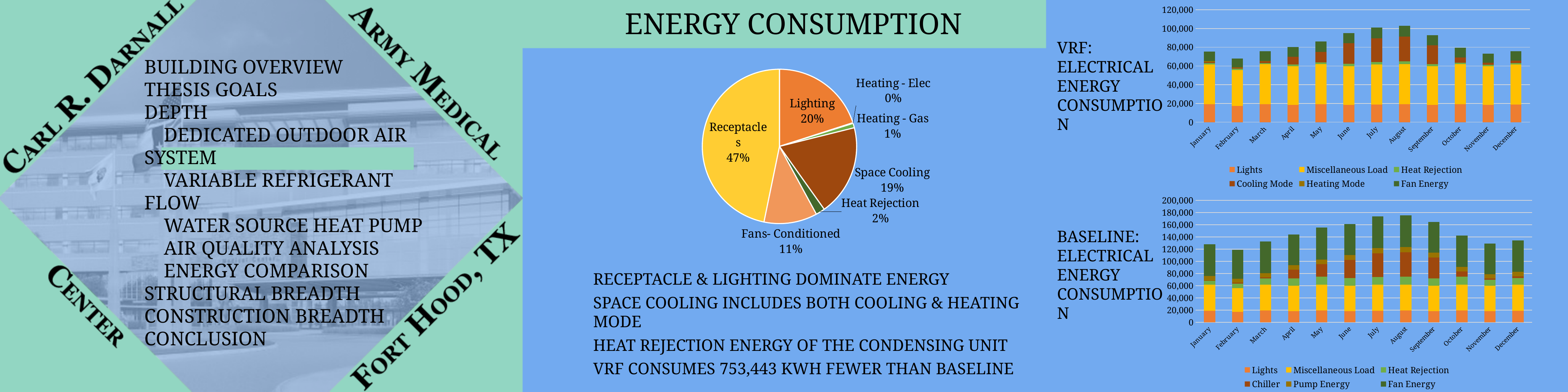
In the pie chart, which is larger, Lighting or Space Cooling? Lighting In the pie chart, which category has the smallest share? Heating - Elec In the pie chart, what share of energy consumption is Space Cooling? 19% In the Baseline: Electrical Energy Consumption chart, is the total for August greater or less than 160,000? greater In the pie chart, what is the difference between the Lighting share and the Fans- Conditioned share? 9% How many series does the legend of the VRF: Electrical Energy Consumption chart list? 6 In the VRF: Electrical Energy Consumption chart, is the total for January greater or less than 80,000? less How many categories does the pie chart show? 7 In the Baseline: Electrical Energy Consumption chart, which month has the lowest total? February In the pie chart, what share of energy consumption is Receptacles? 47% What kind of chart is the VRF: Electrical Energy Consumption chart? Stacked bar chart In the pie chart, which category has the largest share? Receptacles